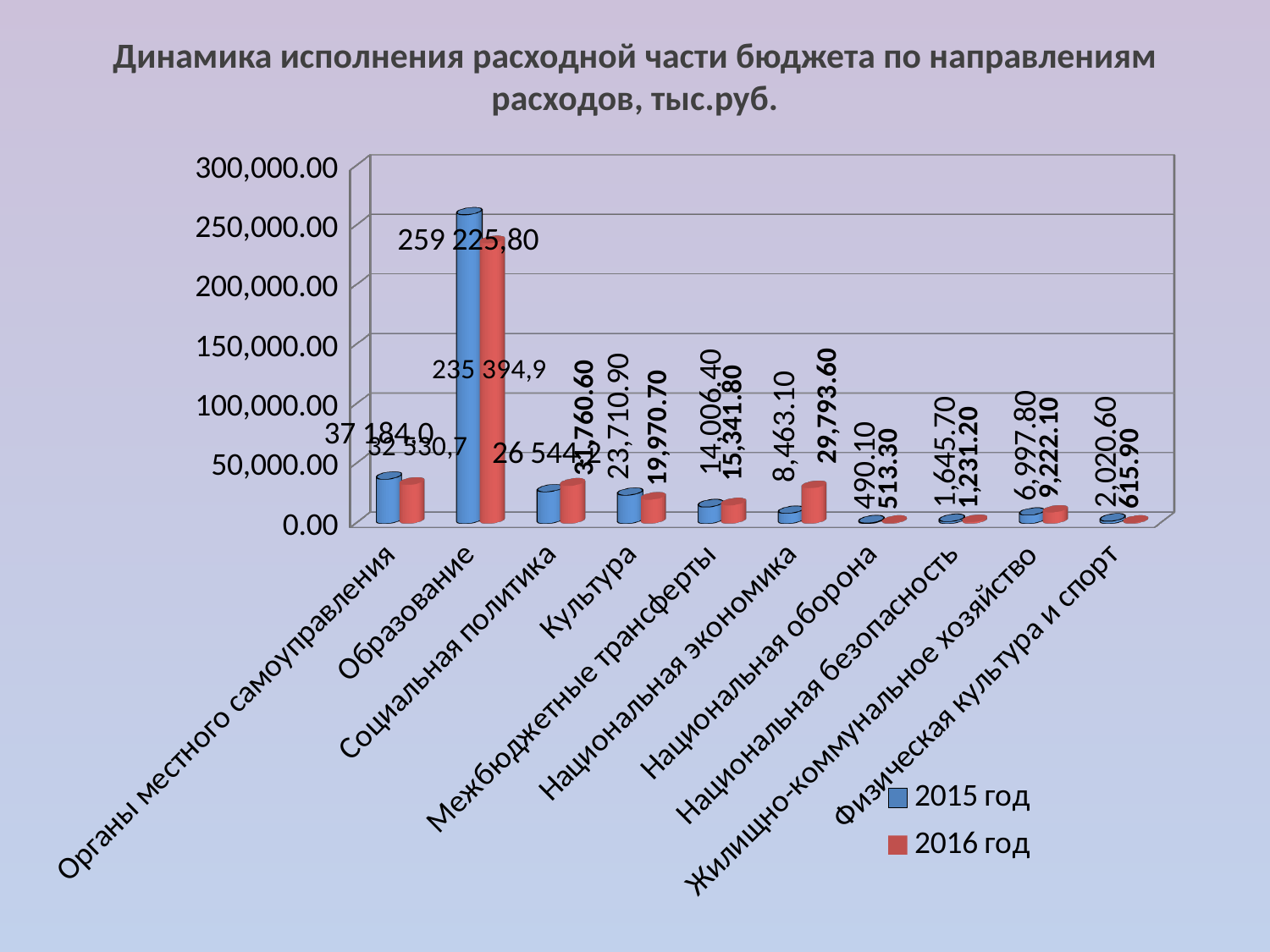
What is the value for Физическая культура и спорт in 2016 год? 615.90 Is the value for Образование in 2015 год greater or less than 250,000.00? greater What is the difference between the 2015 год and 2016 год values for Культура? 3,740.20 What is the value for Национальная оборона in 2015 год? 490.10 What kind of chart is shown on the slide? bar chart Which category has the lowest value for 2016 год? Национальная оборона How many series does the legend list? 2 Which category has the highest value for 2015 год? Образование How many expenditure categories are shown on the x axis? 10 What is the value for Культура in 2016 год? 19,970.70 What is the value for Национальная экономика in 2016 год? 29,793.60 For Национальная экономика, which year has the larger value, 2015 год or 2016 год? 2016 год